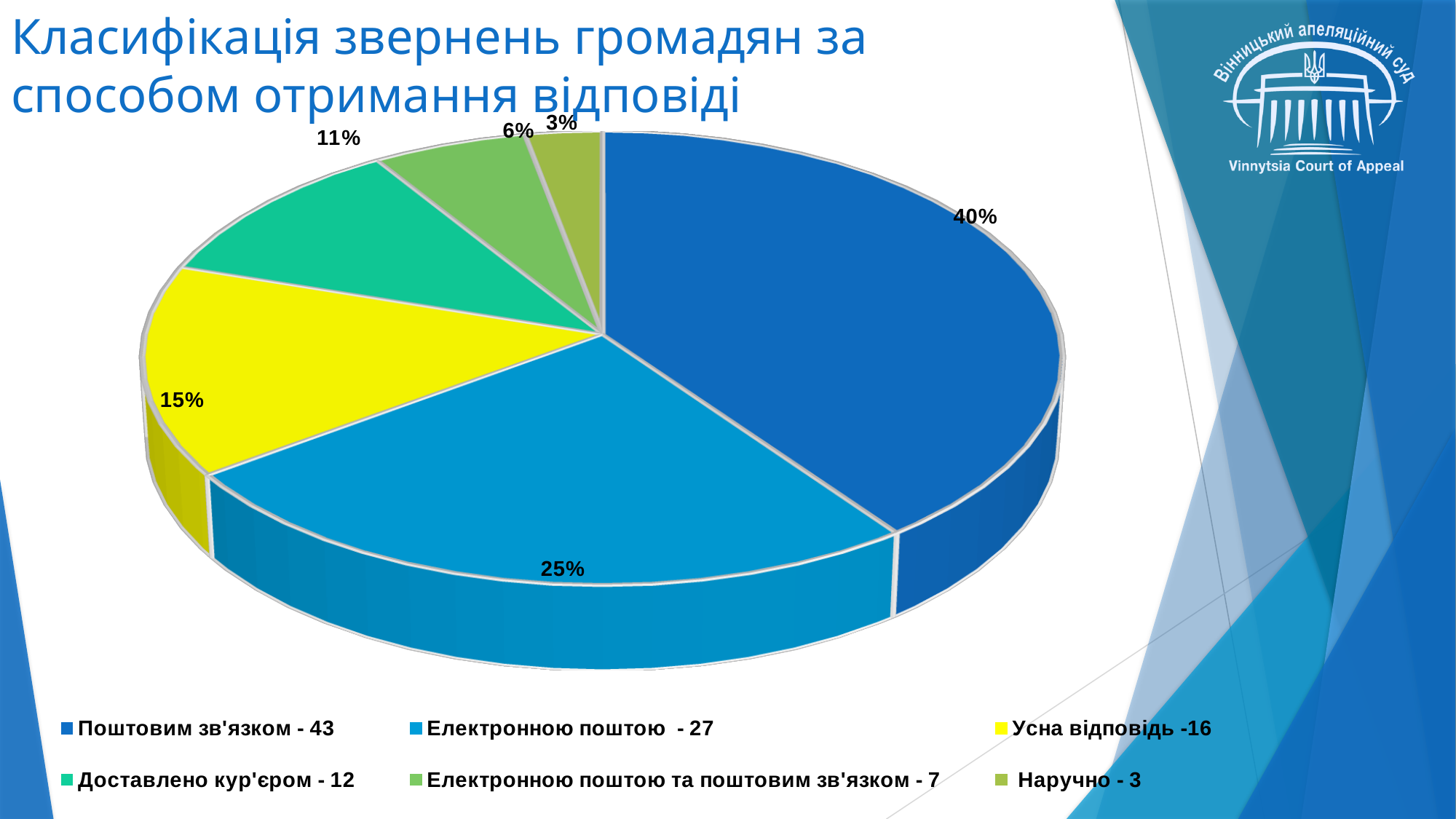
Which slice is larger: "Усна відповідь" or "Електронною поштою та поштовим зв'язком"? Усна відповідь What number is shown in the legend next to "Доставлено кур'єром"? 12 How many categories are shown in the pie chart? 6 What percentage share does the slice for "Доставлено кур'єром" have? 11% Which category has the largest slice of the pie? Поштовим зв'язком Which category has the smallest slice of the pie? Наручно What percentage share does the slice for "Наручно" have? 3% What percentage share does the slice for "Поштовим зв'язком" have? 40% What kind of chart is shown on the slide? Pie chart What is the difference in percentage points between the "Поштовим зв'язком" slice and the "Електронною поштою" slice? 15